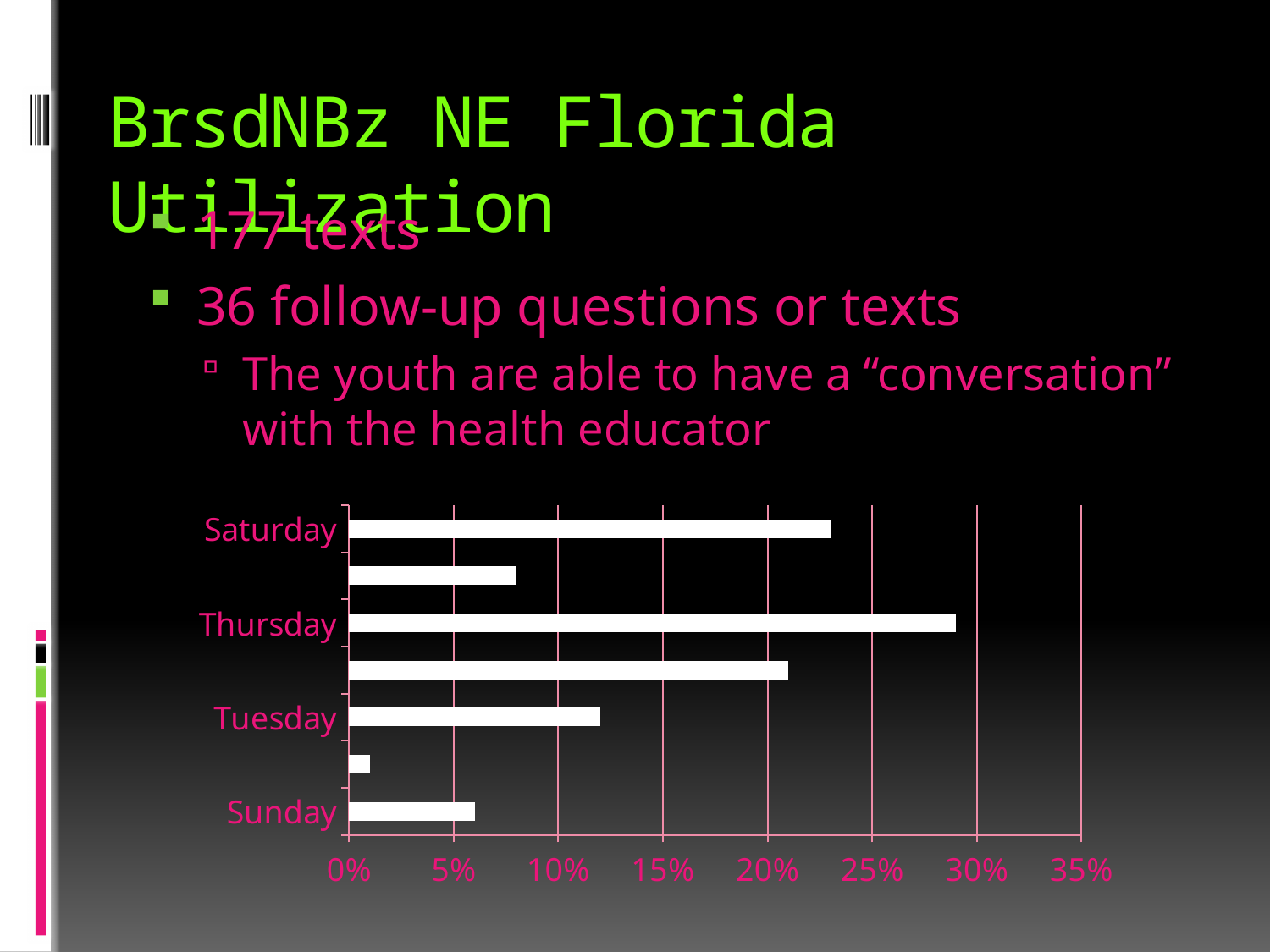
Which is larger, the value for Tuesday or the value for Sunday? Tuesday What colour are the bars in the chart? white Which labeled category has the highest value in the chart? Thursday What kind of chart is shown on the slide? bar chart Is the value for Thursday greater or less than 25%? greater Is the value for Sunday greater or less than 10%? less How many bars does the chart contain? 7 What is the highest value shown on the horizontal axis of the chart? 35% Which is larger, the value for Saturday or the value for Thursday? Thursday Is the value for Tuesday greater or less than 15%? less